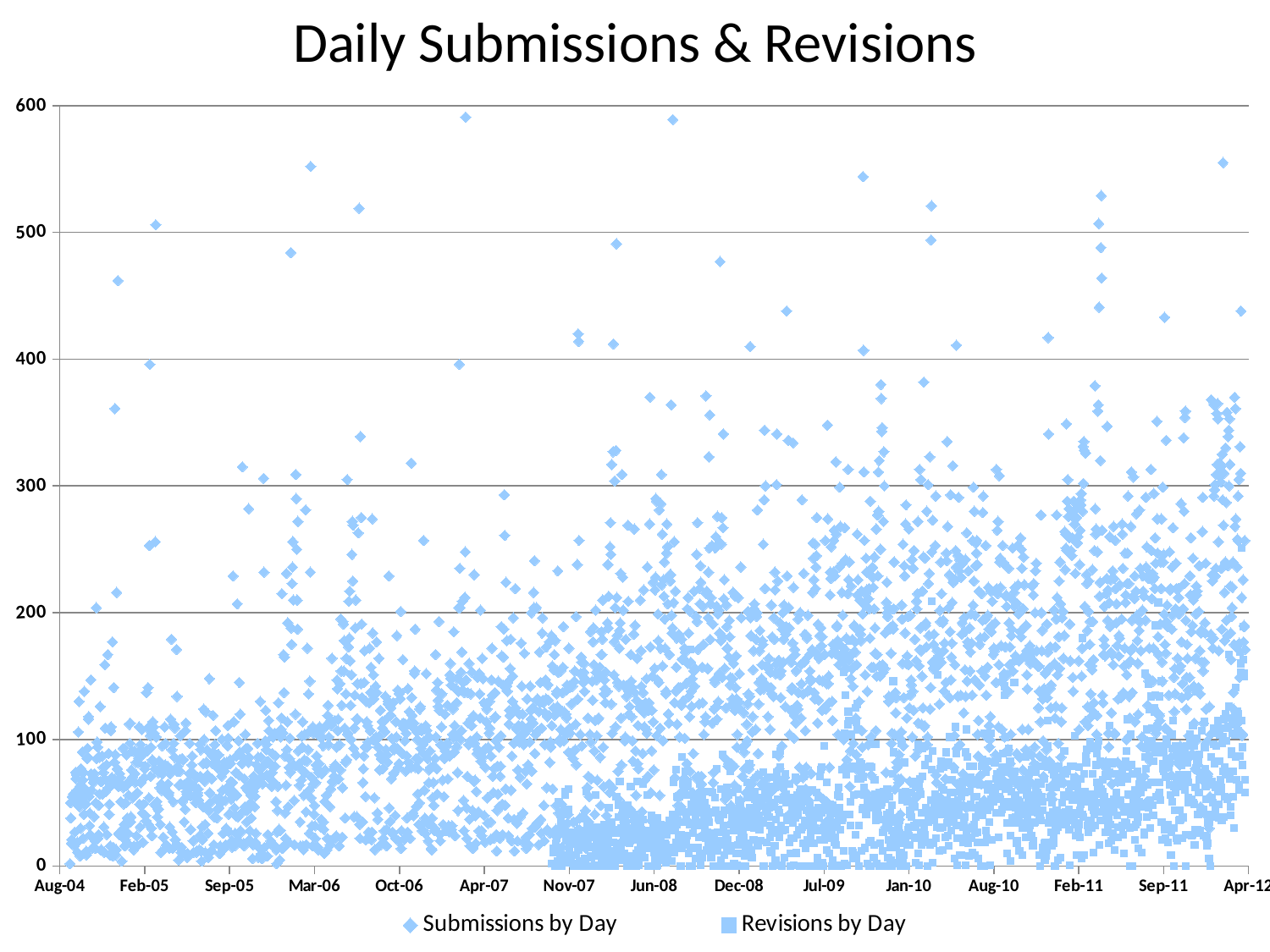
What is the first date label on the x axis? Aug-04 What is the last date label on the x axis? Apr-12 What is the title of the chart? Daily Submissions & Revisions Which series reaches higher values on the chart, Submissions by Day or Revisions by Day? Submissions by Day What is the highest value shown on the y axis? 600 How many date labels are shown along the x axis? 15 How many series does the legend list? 2 Which two series are listed in the legend? Submissions by Day and Revisions by Day Is the highest Revisions by Day value on the chart greater or less than 300? less What kind of chart is shown on the slide? scatter chart Is the highest Submissions by Day value on the chart greater or less than 500? greater Do the Submissions by Day values generally rise or fall from Aug-04 to Apr-12? rise